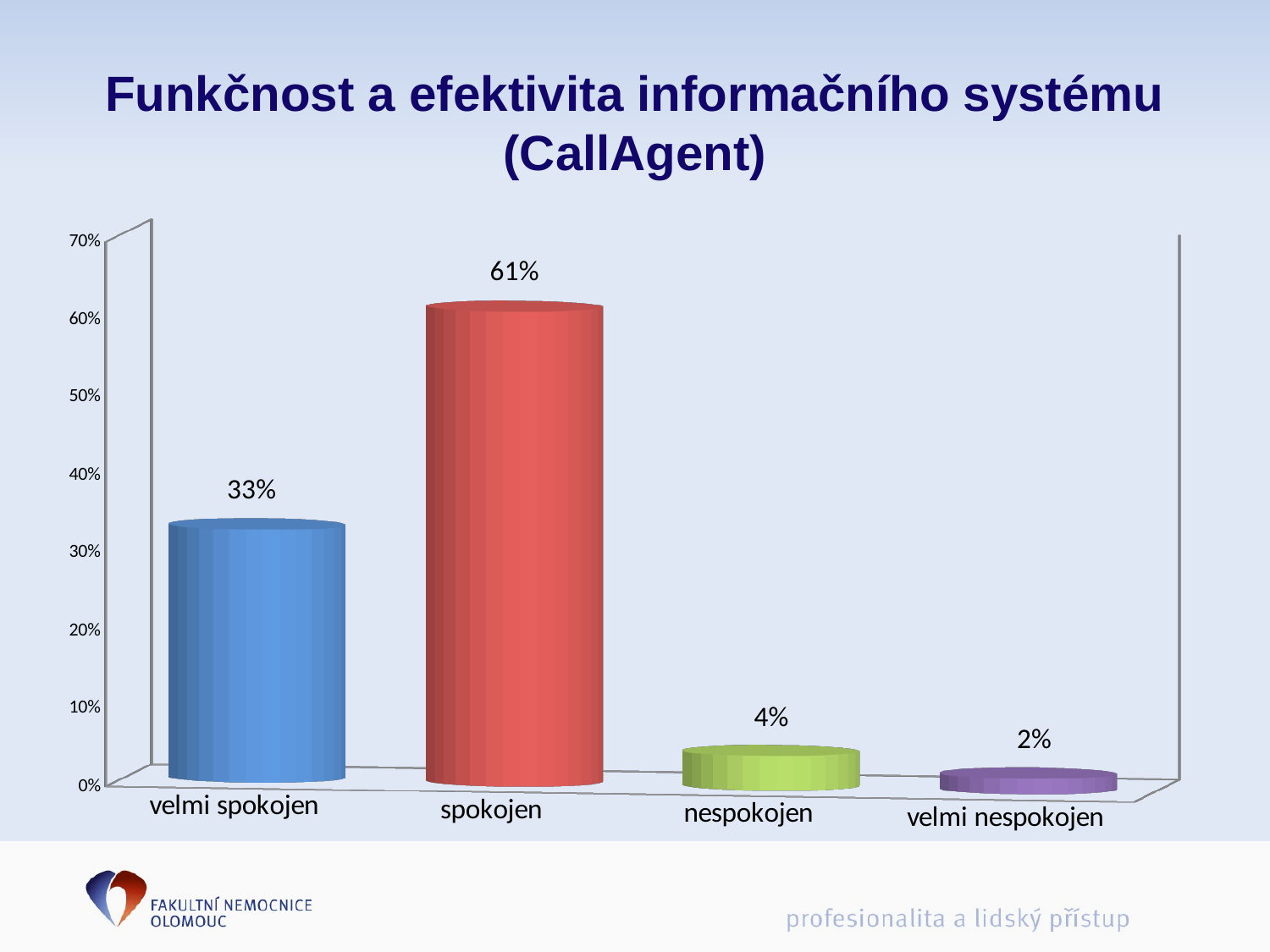
What is the value for "velmi spokojen"? 33% What is the value for "spokojen"? 61% What is the value for "nespokojen"? 4% Is the value for "velmi spokojen" greater or less than 30%? greater Which is larger, the value for "nespokojen" or the value for "velmi nespokojen"? nespokojen What kind of chart is shown on the slide? bar chart Which category has the lowest value? velmi nespokojen What is the value for "velmi nespokojen"? 2% What is the title of the chart? Funkčnost a efektivita informačního systému (CallAgent) What is the difference between the values for "spokojen" and "velmi spokojen"? 28% How many categories are shown on the x axis? 4 Which category has the highest value? spokojen